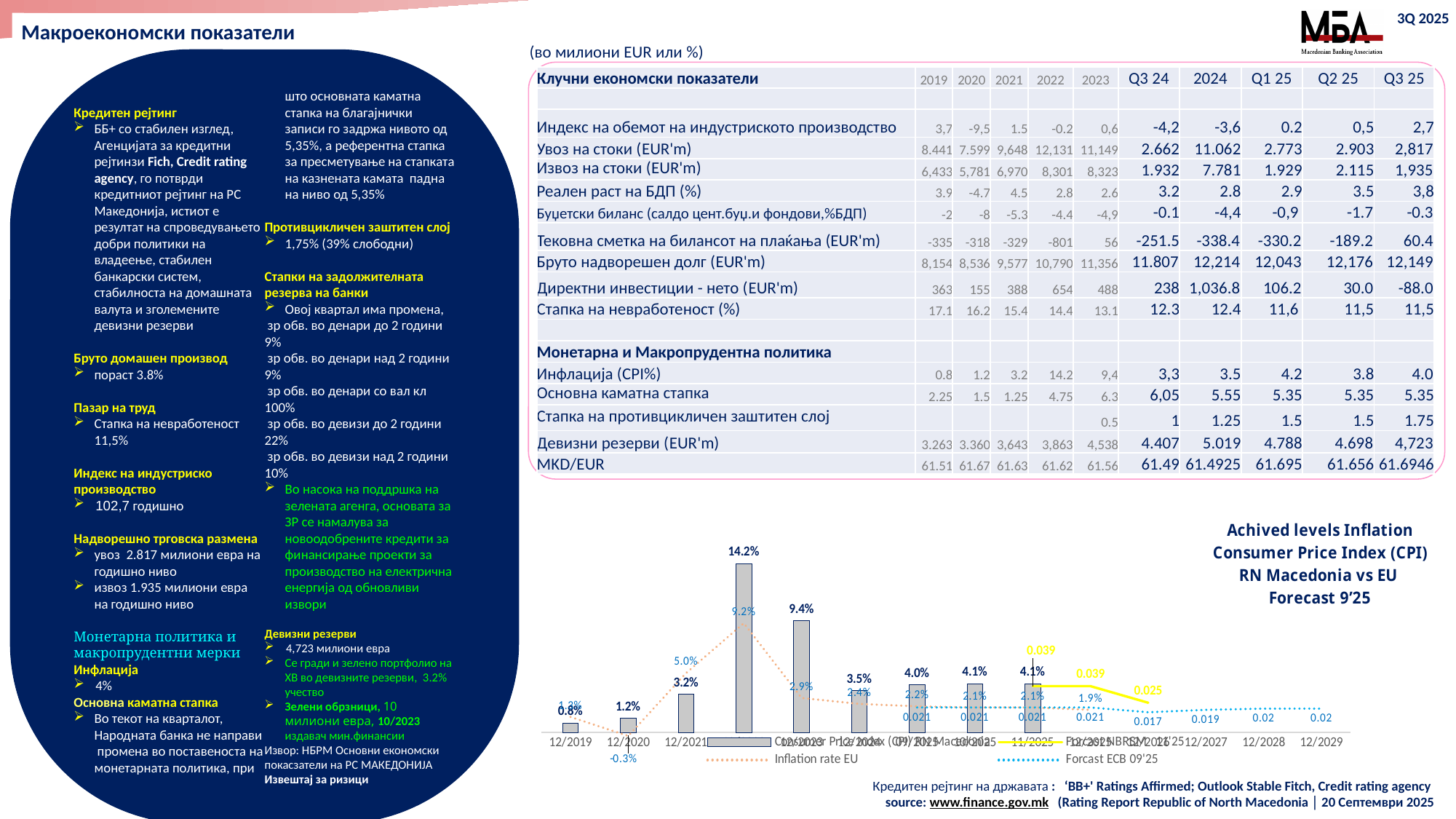
In the inflation chart, which period has the highest CPI bar for RN Macedonia? 12/2022 In the inflation chart, what is the difference between the RN Macedonia CPI at 12/2022 and at 12/2023? 4.8 percentage points In the inflation chart, what is the CPI value for RN Macedonia at 12/2022? 14.2% In the inflation chart, what is the Inflation rate EU value at 12/2021? 5.0% What kind of chart is used to show the Consumer Price Index (CPI) RN Macedonia series in the inflation chart? bar chart How many CPI bars for RN Macedonia are plotted in the inflation chart? 9 In the inflation chart, do the RN Macedonia CPI bars rise or fall from 12/2022 to 12/2024? fall In the inflation chart, what is the CPI value for RN Macedonia at 12/2023? 9.4% How many series does the legend of the inflation chart list? 4 In the inflation chart, which is larger: the RN Macedonia CPI at 12/2021 or at 12/2024? 12/2024 In the inflation chart, which period has the lowest CPI bar for RN Macedonia? 12/2019 In the inflation chart, what is the Inflation rate EU value at 12/2020? -0.3%